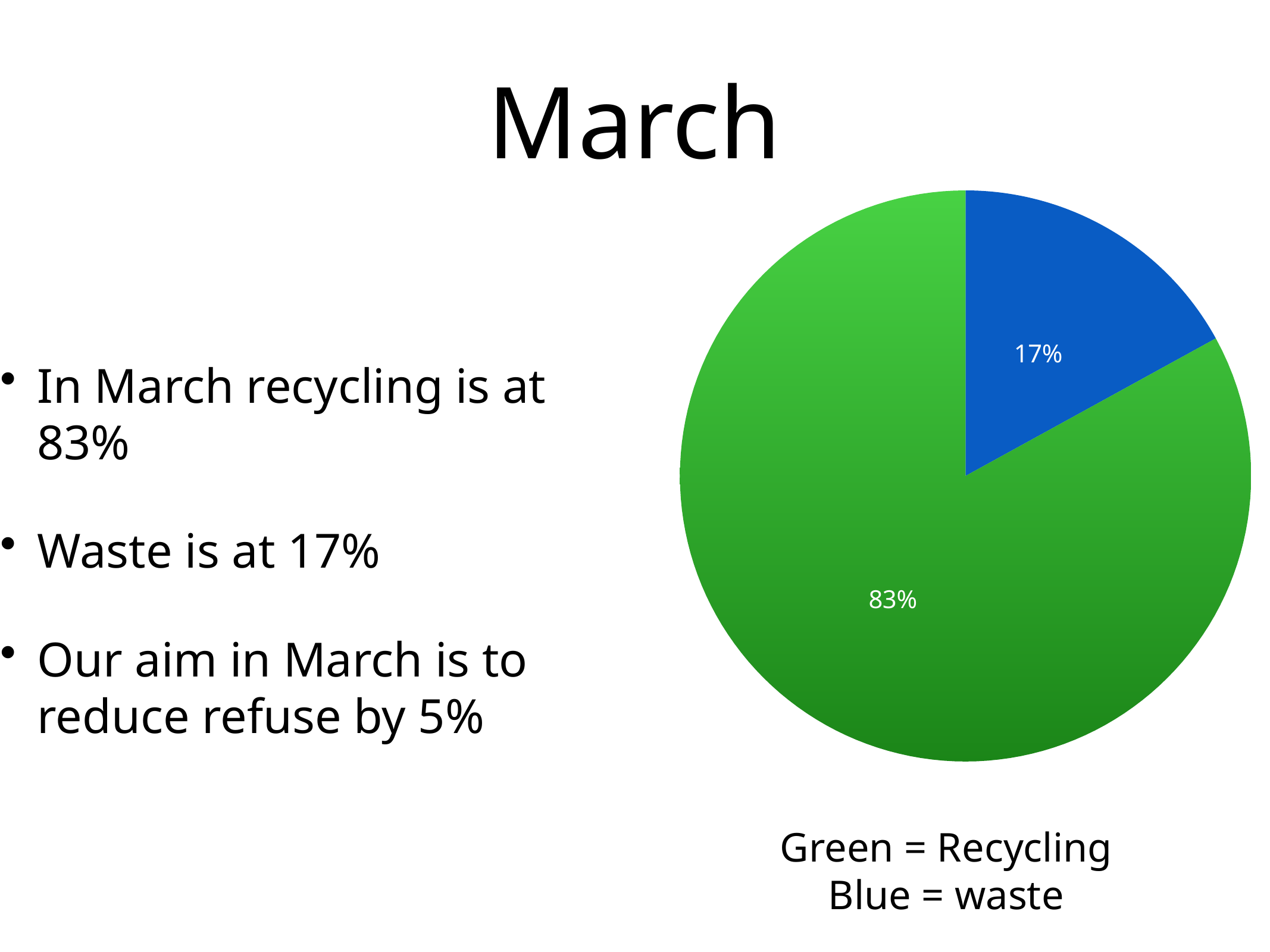
What is the difference between the Recycling share and the waste share? 66% Which is larger, the Recycling slice or the waste slice? Recycling What colour represents Recycling in the pie chart? Green What kind of chart is shown on the slide? pie chart What is the total of the two slices shown in the pie chart? 100% What share of the pie does waste (blue) take? 17% Which slice of the pie is the smallest? waste Which slice of the pie is the largest? Recycling What colour represents waste in the pie chart? Blue How many slices does the pie chart have? 2 What share of the pie does Recycling (green) take? 83%